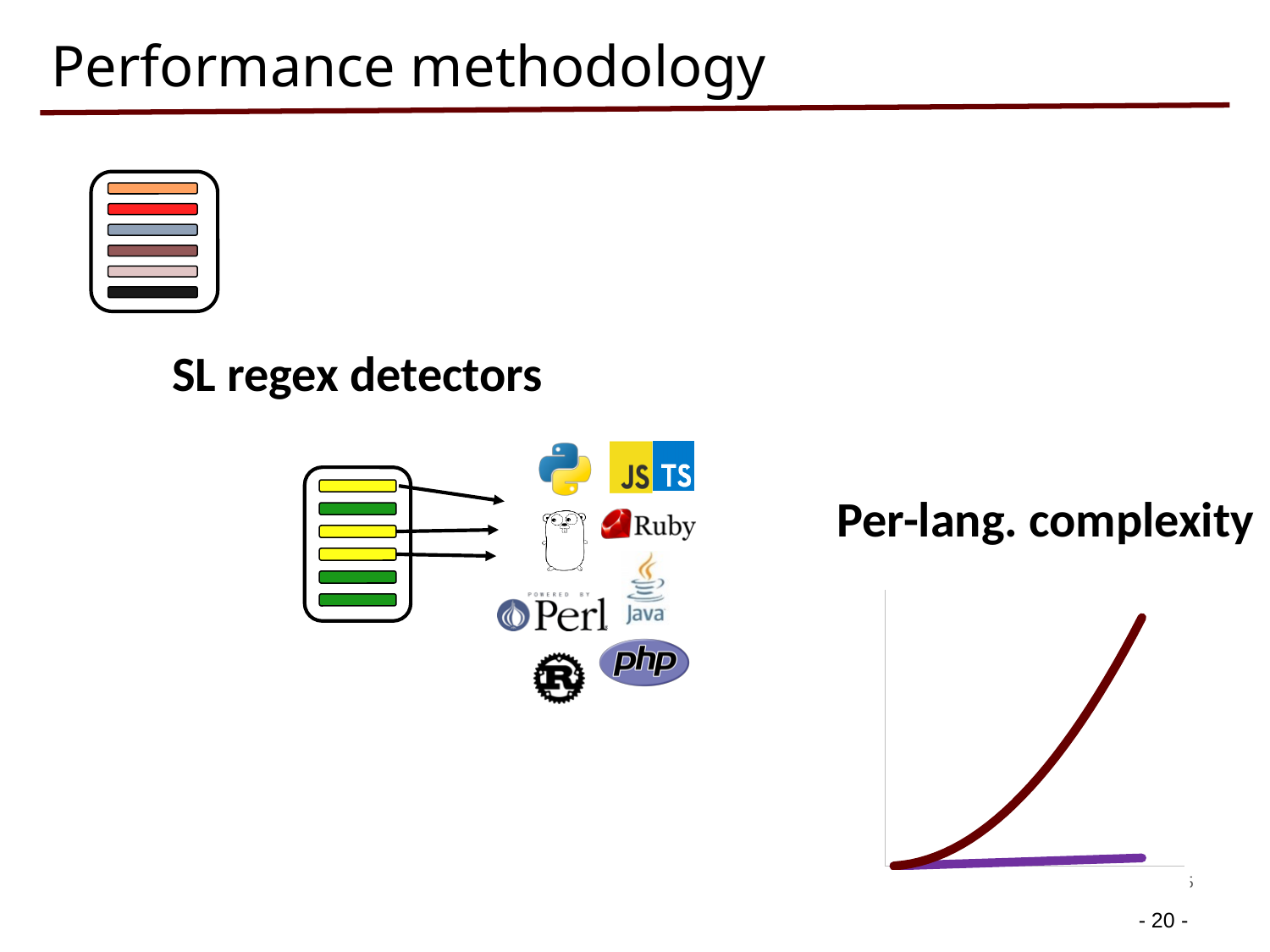
What kind of chart is shown under the heading "Per-lang. complexity"? line chart In the "Per-lang. complexity" chart, does the dark red line rise or fall as it moves to the right along the x axis? rise How many lines are plotted in the "Per-lang. complexity" chart? 2 In the "Per-lang. complexity" chart, which line reaches a higher value at the right end: the dark red line or the purple line? the dark red line What is the heading written above the line chart on the right of the slide? Per-lang. complexity In the "Per-lang. complexity" chart, which line stays nearly flat along the x axis? the purple line